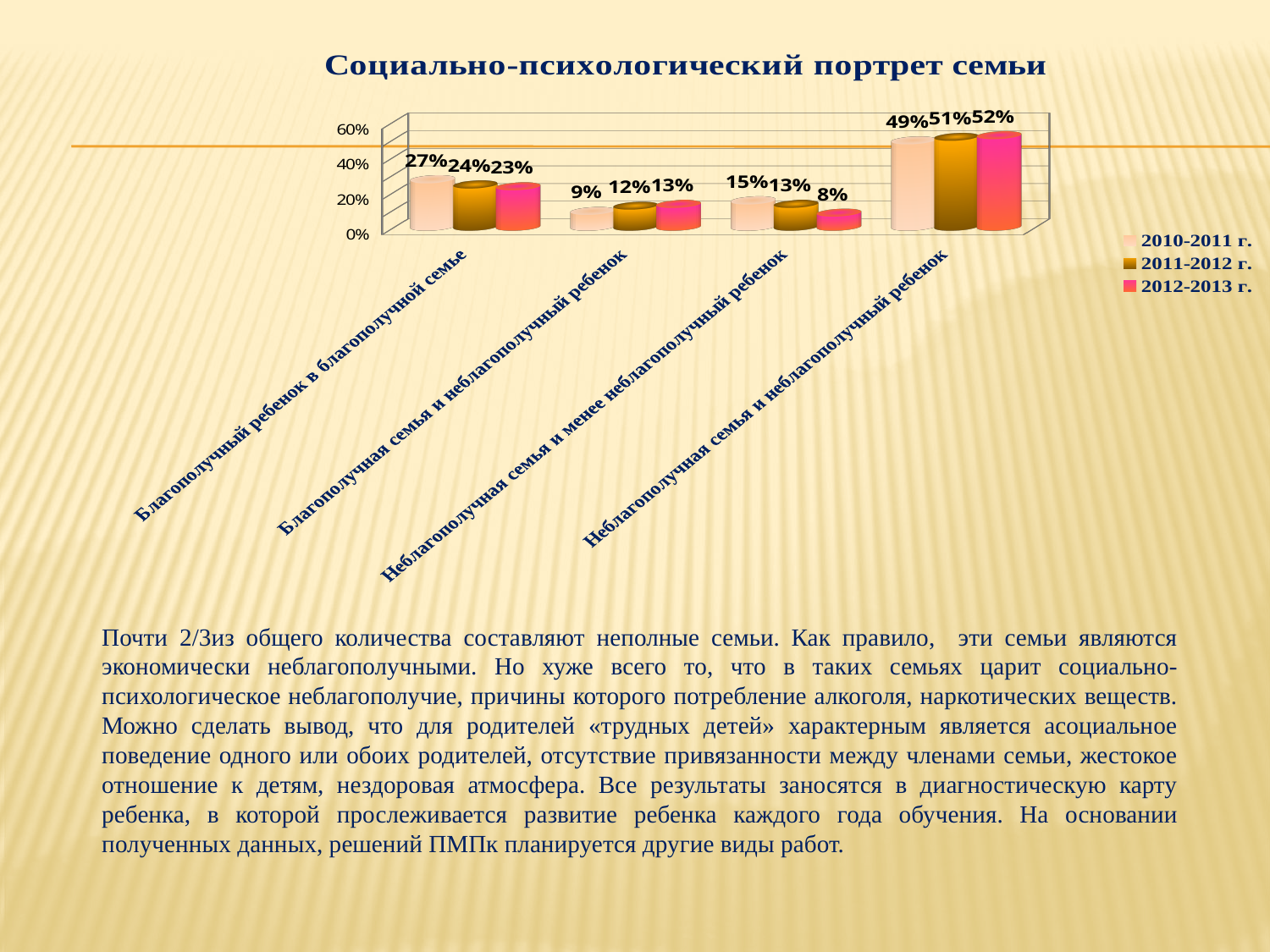
Do the values for 'Благополучный ребенок в благополучной семье' rise or fall from 2010-2011 г. to 2012-2013 г.? fall What is the value for 'Благополучный ребенок в благополучной семье' in the 2010-2011 г. series? 27% What is the value for 'Неблагополучная семья и неблагополучный ребенок' in the 2012-2013 г. series? 52% What is the difference between the 2012-2013 г. and 2010-2011 г. values for 'Неблагополучная семья и неблагополучный ребенок'? 3% What type of chart is shown on the slide? bar chart Which category has the highest value in the 2012-2013 г. series? Неблагополучная семья и неблагополучный ребенок Which category has the lowest value in the 2010-2011 г. series? Благополучная семья и неблагополучный ребенок What is the title of the chart? Социально-психологический портрет семьи How many series does the legend list? 3 What is the value for 'Благополучная семья и неблагополучный ребенок' in the 2011-2012 г. series? 12% Which is larger for 'Неблагополучная семья и менее неблагополучный ребенок': the 2010-2011 г. value or the 2012-2013 г. value? 2010-2011 г. How many categories are shown on the x axis of the chart? 4